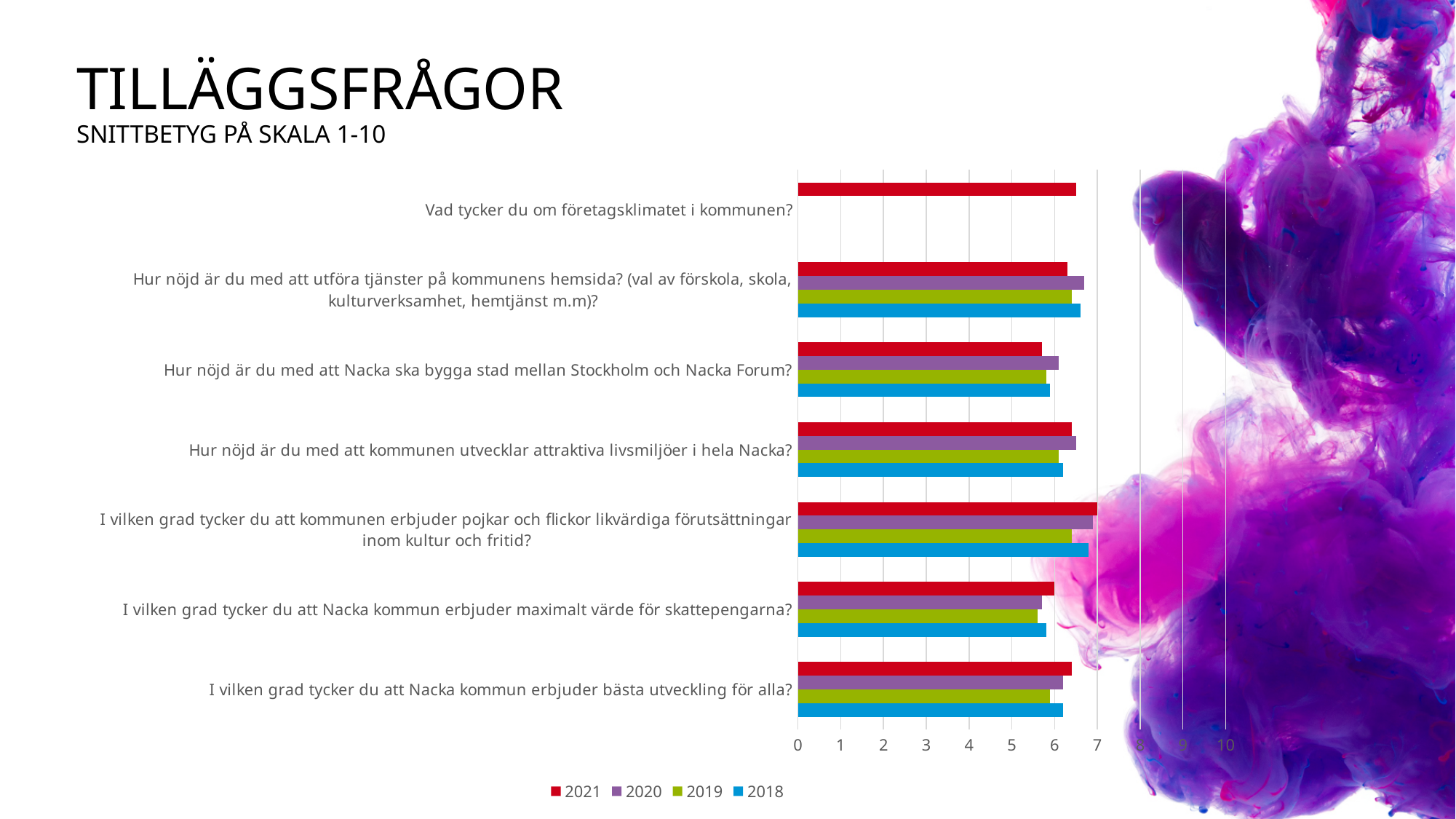
Which category has the highest 2021 value? I vilken grad tycker du att kommunen erbjuder pojkar och flickor likvärdiga förutsättningar inom kultur och fritid? Is the 2018 value for "I vilken grad tycker du att kommunen erbjuder pojkar och flickor likvärdiga förutsättningar inom kultur och fritid?" greater or less than 6? greater For "I vilken grad tycker du att Nacka kommun erbjuder maximalt värde för skattepengarna?", which is larger, the 2021 value or the 2019 value? 2021 How many series does the legend list? 4 What is the subtitle under the chart title TILLÄGGSFRÅGOR? SNITTBETYG PÅ SKALA 1-10 For "Hur nöjd är du med att utföra tjänster på kommunens hemsida?", which is larger, the 2020 value or the 2021 value? 2020 How many question categories are plotted on the chart? 7 Is the 2021 value for "Vad tycker du om företagsklimatet i kommunen?" greater or less than 6? greater Is the 2019 value for "I vilken grad tycker du att Nacka kommun erbjuder maximalt värde för skattepengarna?" greater or less than 6? less Which years are listed in the legend? 2021, 2020, 2019, 2018 What kind of chart is shown on the slide? bar chart